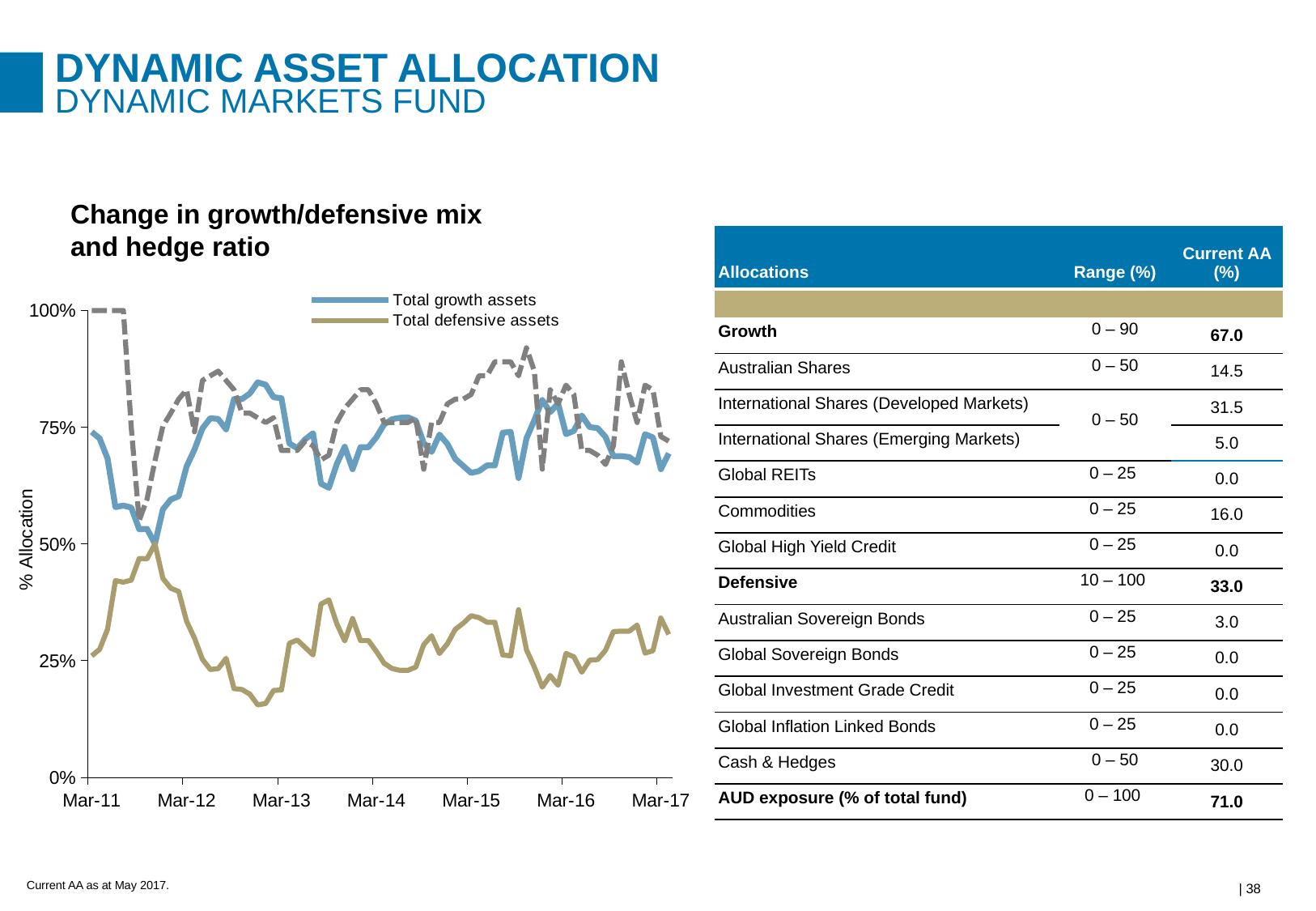
Is the value for Total growth assets at Mar-17 greater or less than 75%? less What is the label on the y axis of the chart? % Allocation What is the title of the chart? Change in growth/defensive mix and hedge ratio Does the Total growth assets line rise or fall between Mar-11 and Mar-12? fall Is the value for Total defensive assets at Mar-17 greater or less than 25%? greater Is the value for Total defensive assets at Mar-12 greater or less than 50%? less What kind of chart is shown on the slide? line chart At Mar-17, which series has the larger value, Total growth assets or Total defensive assets? Total growth assets How many series does the chart legend list? 2 Does the Total defensive assets line rise or fall between Mar-11 and Mar-12? rise